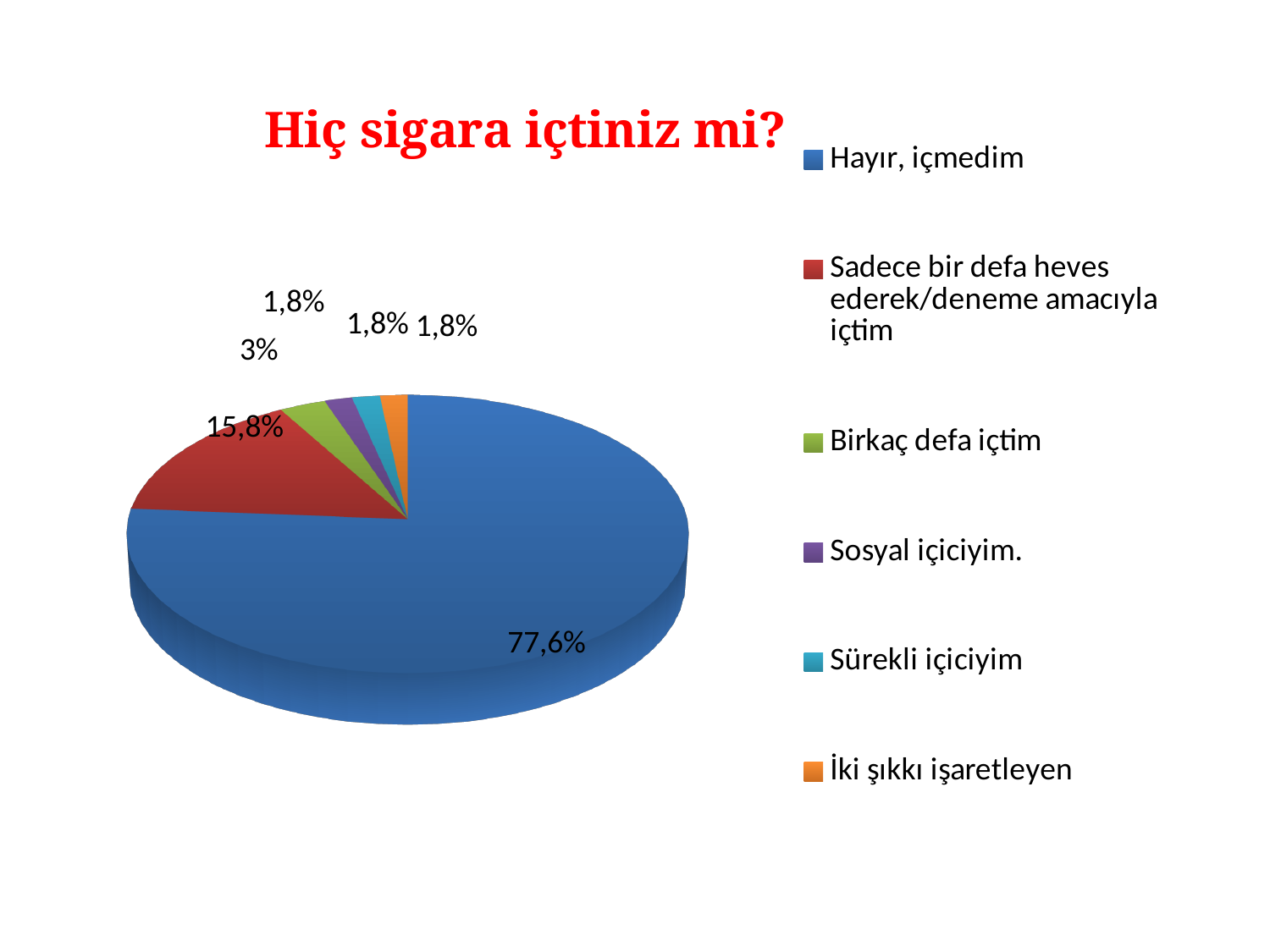
How many categories does the pie chart have? 6 How many entries does the legend list? 6 What percentage of respondents answered "Hayır, içmedim"? 77,6% What percentage is shown for "Sosyal içiciyim."? 1,8% What percentage is shown for "Birkaç defa içtim"? 3% What percentage is shown for "Sadece bir defa heves ederek/deneme amacıyla içtim"? 15,8% What percentage is shown for "Sürekli içiciyim"? 1,8% What is the title of the chart? Hiç sigara içtiniz mi? Which category has the largest share of the pie? Hayır, içmedim What is the difference in percentage points between "Hayır, içmedim" and "Sadece bir defa heves ederek/deneme amacıyla içtim"? 61,8% Which is larger: the share for "Birkaç defa içtim" or the share for "Sürekli içiciyim"? Birkaç defa içtim What kind of chart is shown on the slide? Pie chart